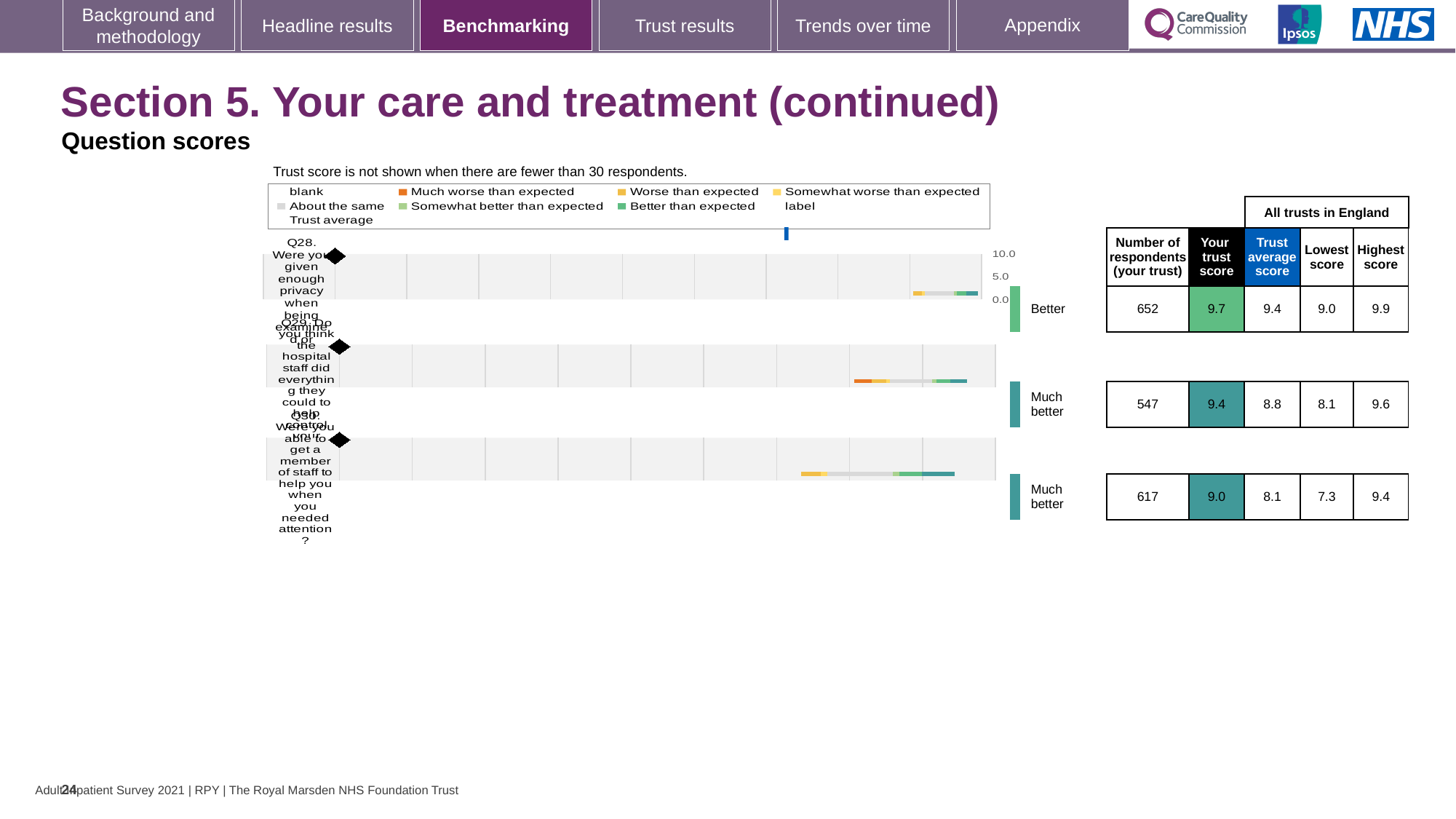
Which question has the highest trust score for this trust? Q28 By how much does the trust score for Q30 exceed the trust average score for Q30? 0.9 What is the trust average score across all trusts in England for Q30? 8.1 What benchmark category label is shown next to the Q28 bar? Better How many questions are plotted in the question scores chart? 3 What is the trust score for Q28 (Were you given enough privacy when being examined or treated)? 9.7 What is the highest score among all trusts in England for Q29? 9.6 Which question has the lowest trust score for this trust? Q30 What kind of chart is used to show the question scores on this slide? bar chart What is the lowest score among all trusts in England for Q30? 7.3 For Q29, which is larger: the trust score or the trust average score? the trust score How many respondents from the trust answered Q29? 547